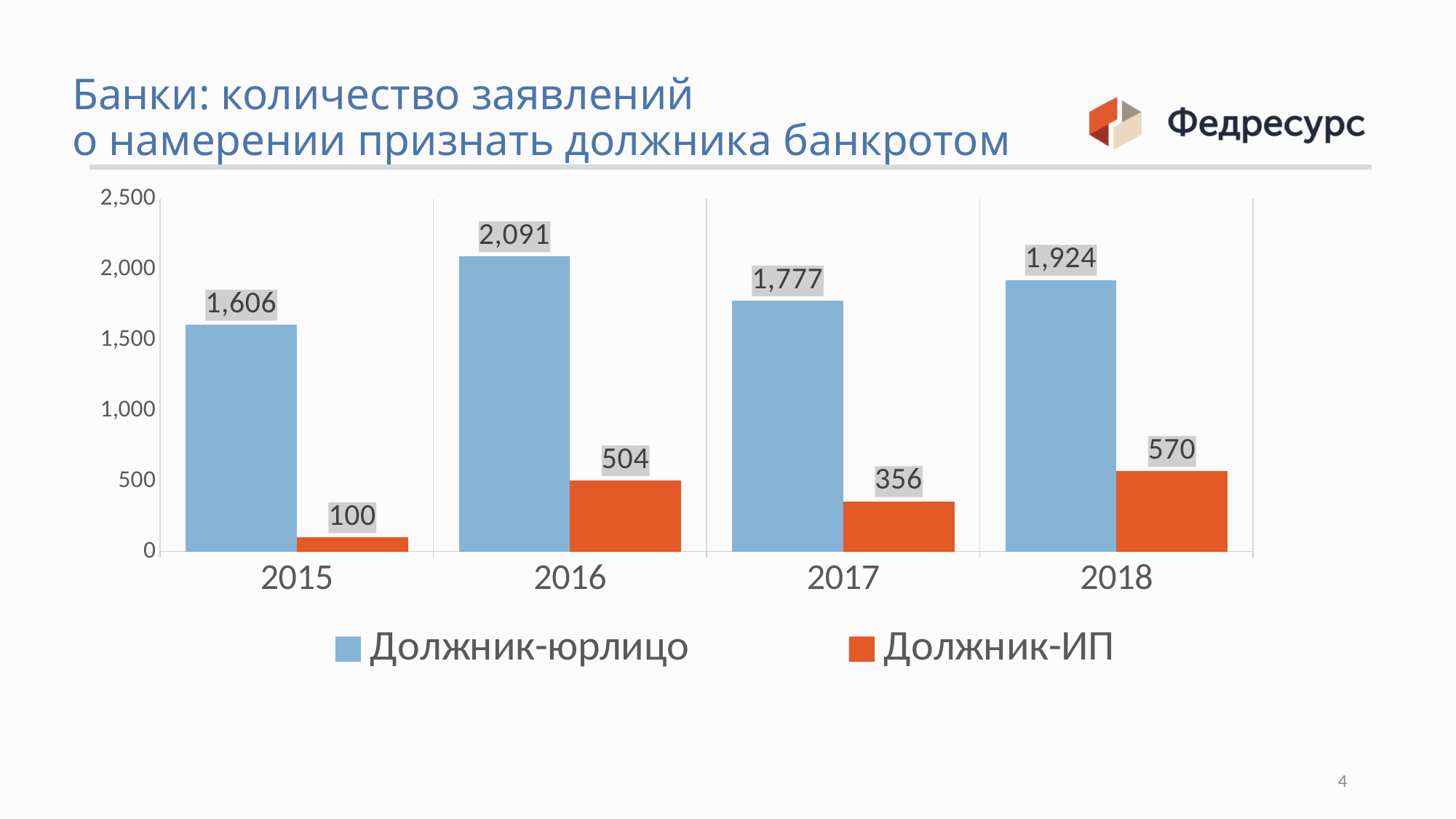
Is the value for Должник-юрлицо in 2015 greater or less than 1,500? greater In which year is the value for Должник-юрлицо highest? 2016 Which is larger: the Должник-ИП value in 2016 or in 2018? 2018 What is the difference between the Должник-юрлицо and Должник-ИП values in 2017? 1,421 Which colour represents the Должник-ИП series? orange In which year is the value for Должник-ИП lowest? 2015 How many series does the legend list? 2 What is the value for Должник-ИП in 2015? 100 What is the value for Должник-ИП in 2018? 570 How many years are shown on the x axis? 4 What is the value for Должник-юрлицо in 2016? 2,091 What kind of chart is shown on the slide? bar chart